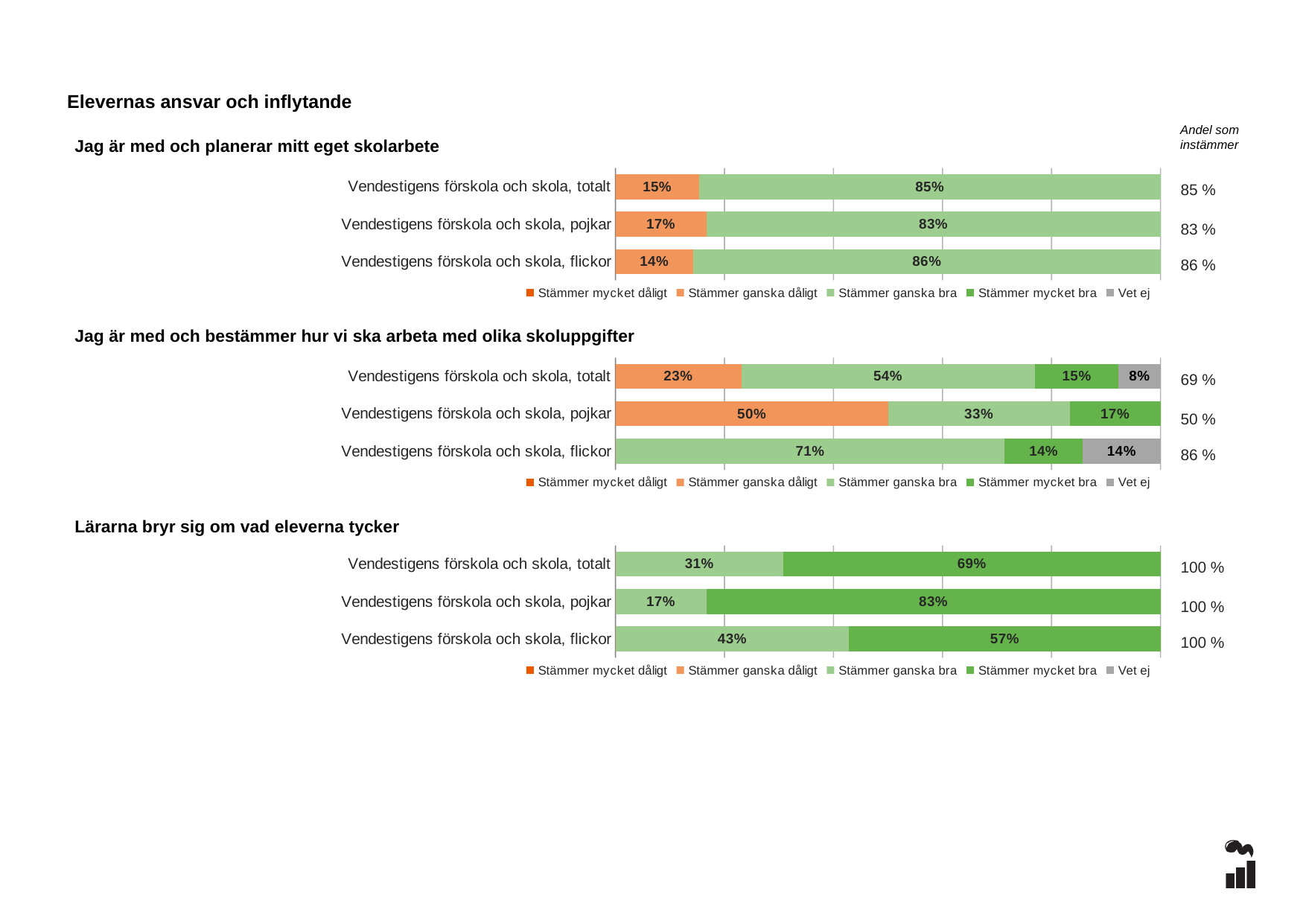
In the chart 'Lärarna bryr sig om vad eleverna tycker', what is the 'Stämmer mycket bra' value for Vendestigens förskola och skola, flickor? 57% In the chart 'Lärarna bryr sig om vad eleverna tycker', what is the difference between the 'Stämmer mycket bra' values for pojkar and flickor? 26% In the chart 'Jag är med och planerar mitt eget skolarbete', what is the 'Stämmer ganska dåligt' value for Vendestigens förskola och skola, flickor? 14% In the chart 'Jag är med och bestämmer hur vi ska arbeta med olika skoluppgifter', what is the 'Vet ej' value for Vendestigens förskola och skola, totalt? 8% In the chart 'Jag är med och planerar mitt eget skolarbete', what is the 'Stämmer ganska bra' value for Vendestigens förskola och skola, pojkar? 83% What kind of chart is 'Jag är med och bestämmer hur vi ska arbeta med olika skoluppgifter'? Stacked bar chart In the chart 'Jag är med och bestämmer hur vi ska arbeta med olika skoluppgifter', is the 'Stämmer ganska dåligt' value larger for totalt or for pojkar? pojkar In the chart 'Jag är med och bestämmer hur vi ska arbeta med olika skoluppgifter', which category has the highest 'Stämmer ganska bra' value? Vendestigens förskola och skola, flickor In the chart 'Jag är med och bestämmer hur vi ska arbeta med olika skoluppgifter', what is the 'Stämmer ganska dåligt' value for Vendestigens förskola och skola, pojkar? 50% In the chart 'Lärarna bryr sig om vad eleverna tycker', which category has the lowest 'Stämmer ganska bra' value? Vendestigens förskola och skola, pojkar How many categories are shown in the chart 'Lärarna bryr sig om vad eleverna tycker'? 3 How many series does the legend of the chart 'Jag är med och planerar mitt eget skolarbete' list? 5